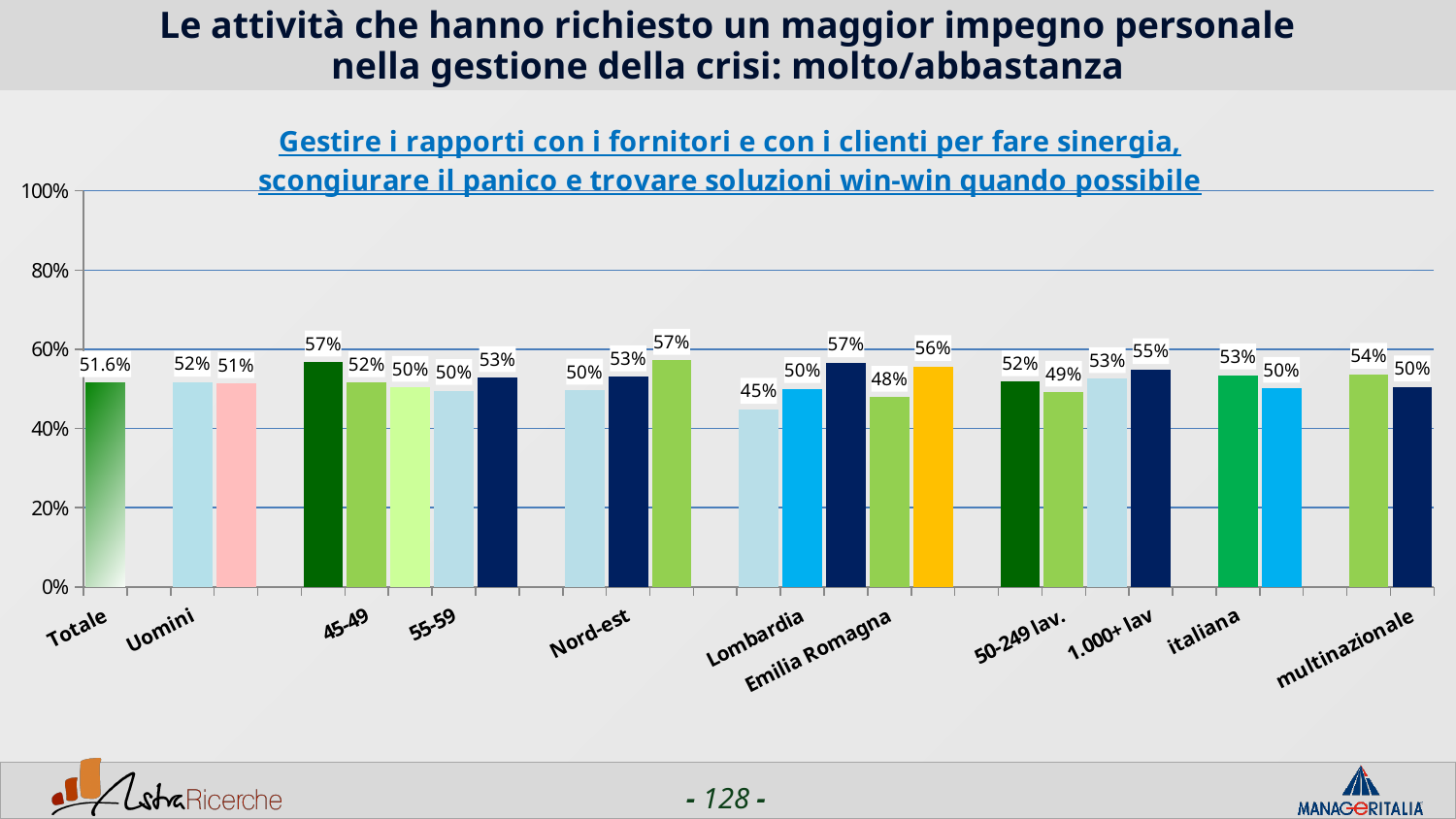
What is the value for Nord-est? 53% Which is larger, the value for Nord-est or the value for Emilia Romagna? Nord-est What is the difference between the value for 1.000+ lav and the value for 50-249 lav.? 6 percentage points Is the value for Totale greater or less than 60%? less What is the value for Lombardia? 50% What is the value for 1.000+ lav? 55% What is the lowest value shown on any bar in the chart? 45% What is the value for Totale? 51.6% What kind of chart is shown on the slide? Bar chart What is the value for Emilia Romagna? 48% What is the highest value shown on any bar in the chart? 57% What is the value for Uomini? 52%